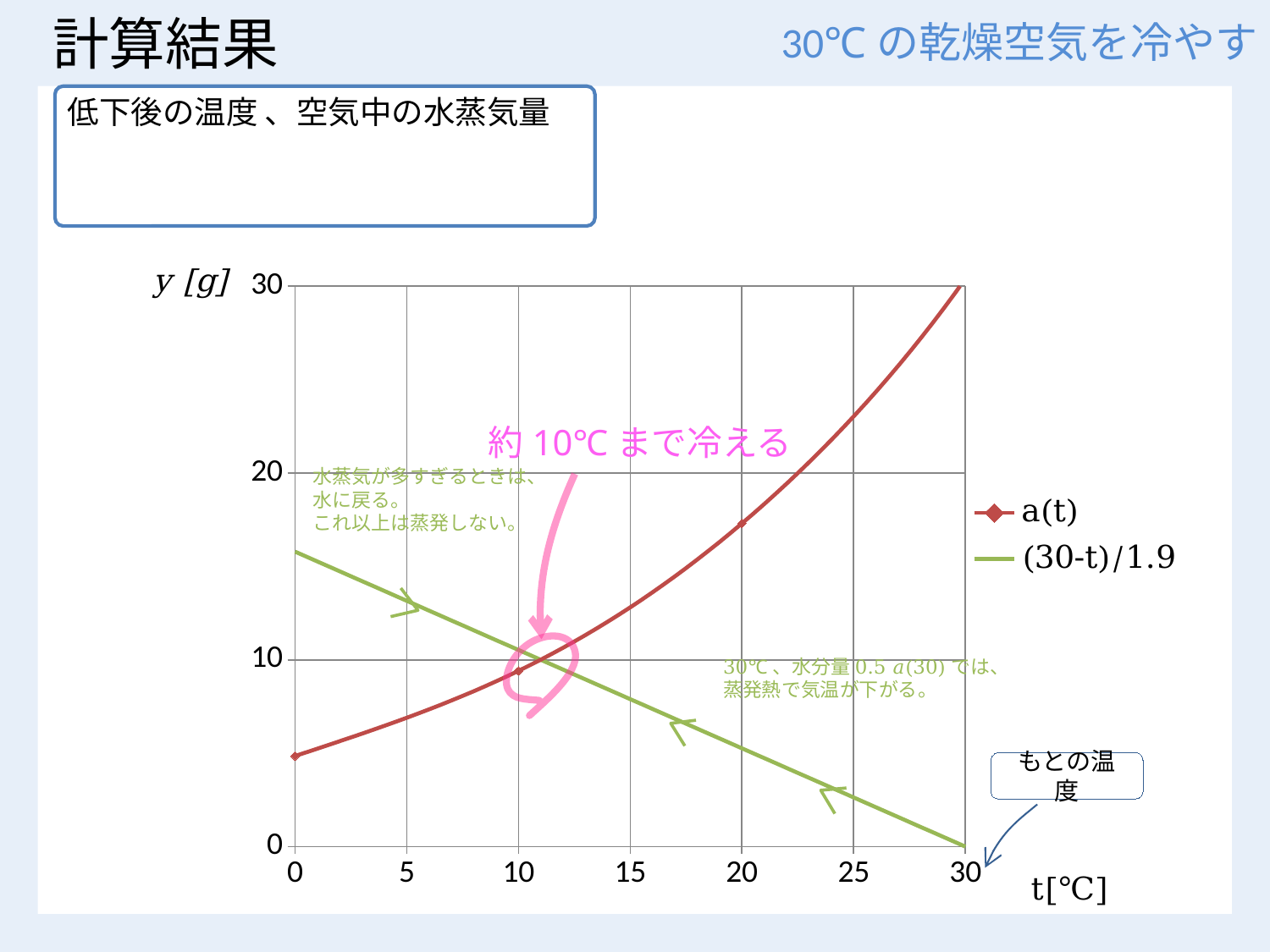
Is the value of (30-t)/1.9 at t = 0 greater or less than 10? greater Is the value of a(t) at t = 0 greater or less than 10? less How many series does the legend list? 2 At t = 0, which series has the higher value, a(t) or (30-t)/1.9? (30-t)/1.9 What are the two series named in the legend? a(t) and (30-t)/1.9 At t = 20, which series has the higher value, a(t) or (30-t)/1.9? a(t) What is the label of the x axis? t[℃] What is the value of the (30-t)/1.9 series at t = 30? 0 What kind of chart is shown on the slide? line chart Does the (30-t)/1.9 series rise or fall as t increases along the x axis? fall Does the a(t) series rise or fall as t increases along the x axis? rise